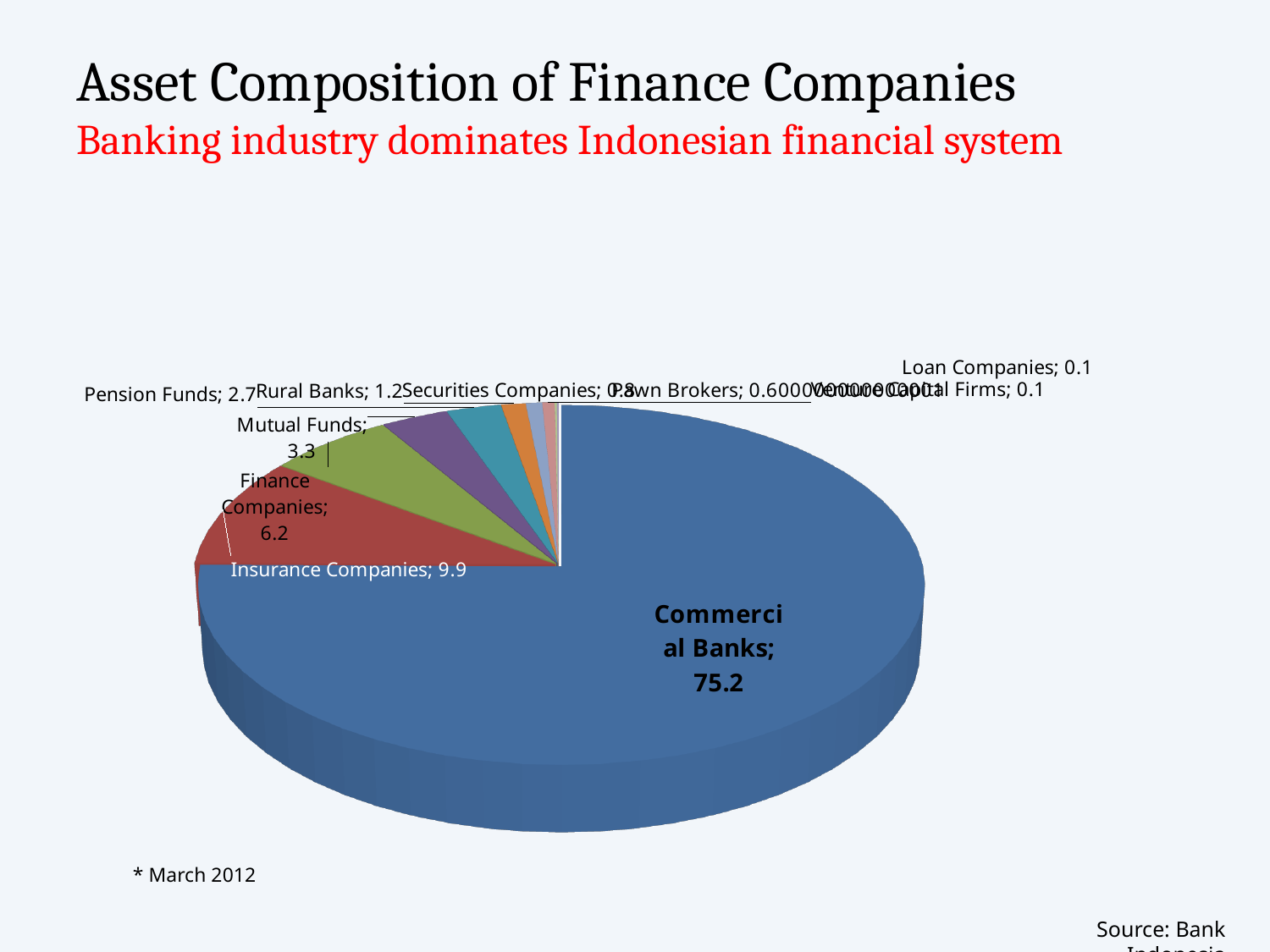
What is the difference between the values for Commercial Banks and Insurance Companies? 65.3 What is the value shown for Finance Companies? 6.2 What is the value shown for Pension Funds? 2.7 How many categories (slices) are labelled in the pie chart? 10 What is the value shown for Insurance Companies? 9.9 What is the value shown for Mutual Funds? 3.3 What kind of chart is shown on the slide? Pie chart Which is larger, the value for Insurance Companies or the value for Finance Companies? Insurance Companies What is the difference between the values for Insurance Companies and Finance Companies? 3.7 What is the value shown for Rural Banks? 1.2 What is the value shown for Commercial Banks in the pie chart? 75.2 Which category has the largest slice of the pie? Commercial Banks